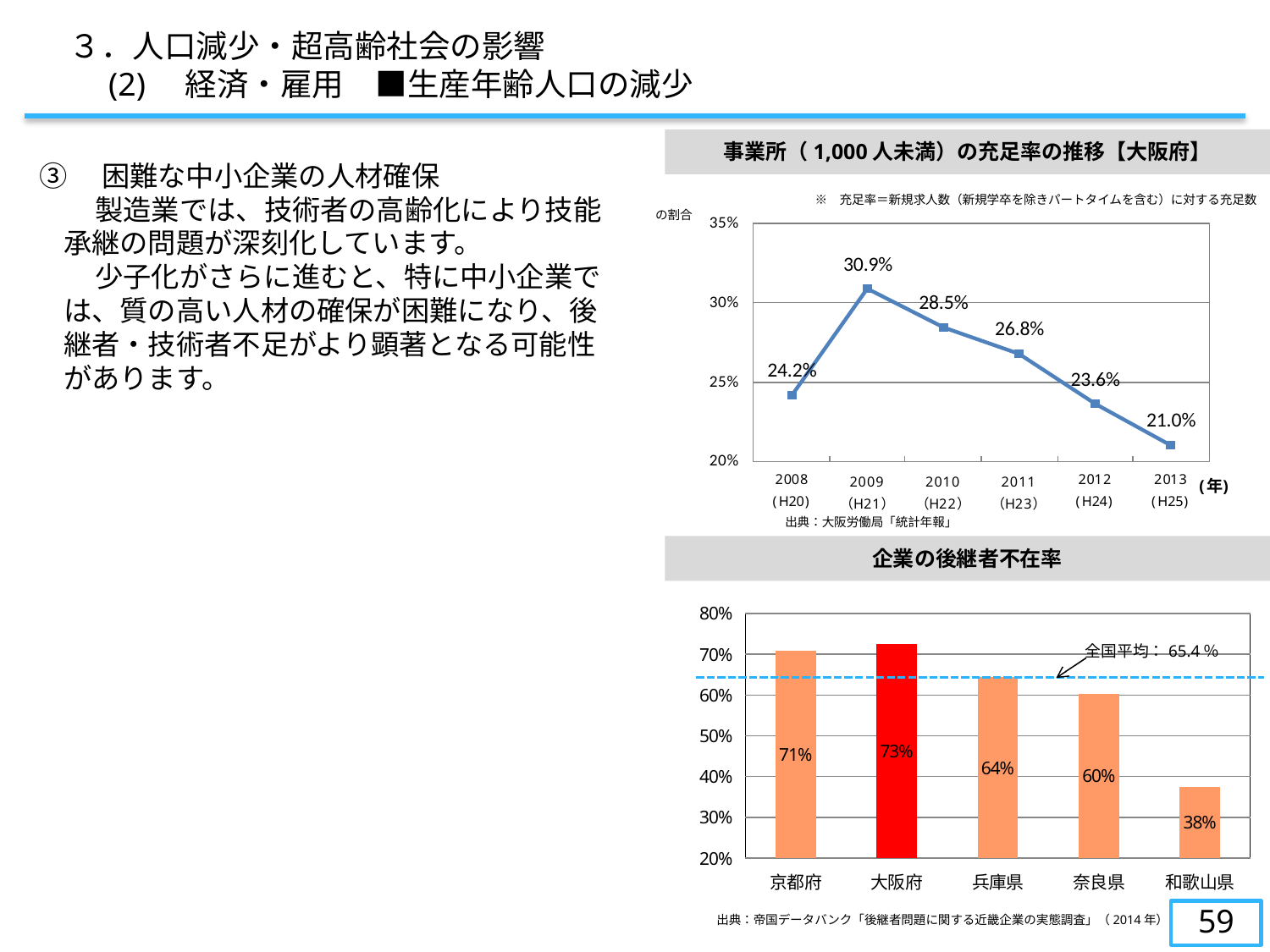
In the chart titled 事業所（1,000人未満）の充足率の推移【大阪府】, which year has the highest value? 2009 (H21) What kind of chart is the one titled 事業所（1,000人未満）の充足率の推移【大阪府】? line chart In the chart titled 事業所（1,000人未満）の充足率の推移【大阪府】, do the values rise or fall from 2009 to 2013? fall In the chart titled 事業所（1,000人未満）の充足率の推移【大阪府】, how many data points are plotted? 6 In the chart titled 企業の後継者不在率, what is the difference between the values for 京都府 and 和歌山県? 33 percentage points In the chart titled 企業の後継者不在率, which is larger, the value for 兵庫県 or the value for 奈良県? 兵庫県 In the chart titled 企業の後継者不在率, which prefecture has the lowest value? 和歌山県 In the chart titled 企業の後継者不在率, what national average (全国平均) value is shown by the dashed line? 65.4% In the chart titled 事業所（1,000人未満）の充足率の推移【大阪府】, what is the difference between the 2009 value and the 2013 value? 9.9 percentage points In the chart titled 企業の後継者不在率, what is the value for 大阪府? 73% In the chart titled 事業所（1,000人未満）の充足率の推移【大阪府】, what is the value for 2013 (H25)? 21.0% In the chart titled 事業所（1,000人未満）の充足率の推移【大阪府】, what is the value for 2009 (H21)? 30.9%